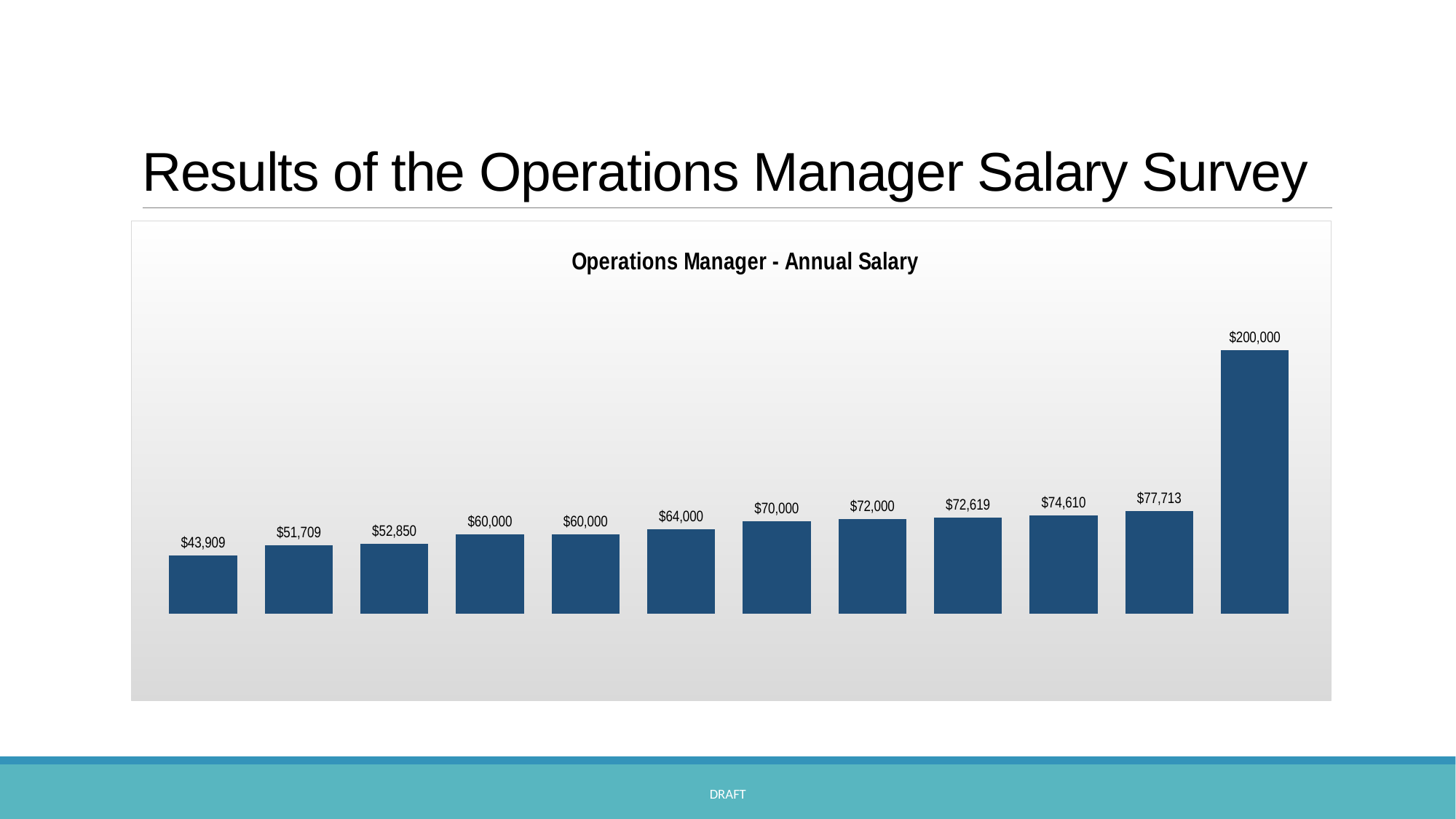
How many bars are plotted in the chart? 12 What is the value of the third bar from the left? $52,850 What is the difference between the second bar from the right ($77,713) and the leftmost bar ($43,909)? $33,804 What is the value of the leftmost bar in the chart? $43,909 What is the highest salary value shown in the chart? $200,000 What is the title of the chart? Operations Manager - Annual Salary What kind of chart is shown on the slide? Bar chart What is the value of the rightmost bar in the chart? $200,000 What is the lowest salary value shown in the chart? $43,909 What is the difference between the highest and lowest values in the chart? $156,091 How many bars in the chart have a value of exactly $60,000? 2 Do the bar values rise or fall from left to right across the chart? Rise